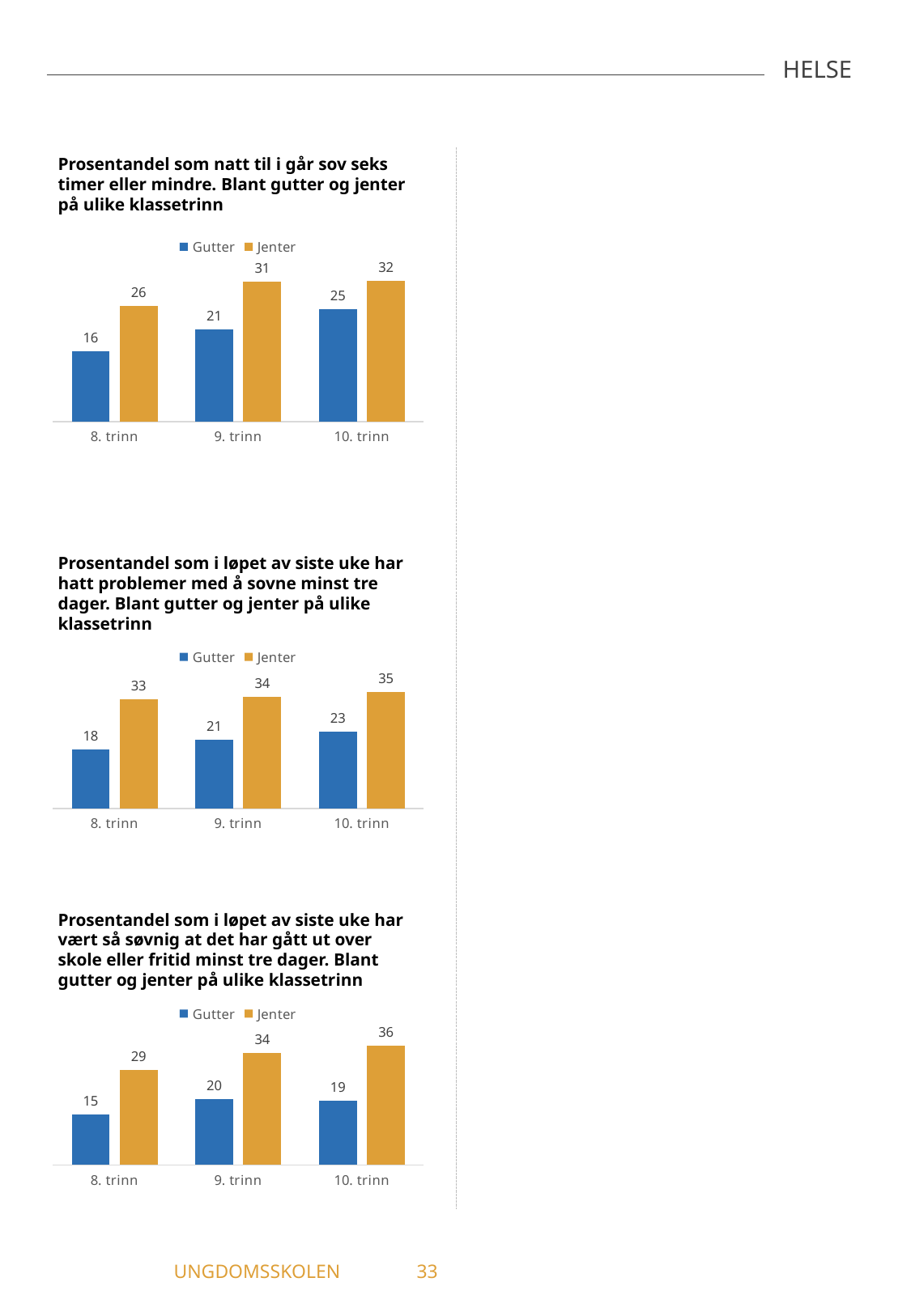
In the top chart (sleeping six hours or less), what is the difference between Jenter and Gutter in 8. trinn? 10 In the bottom chart (so sleepy it affected school or leisure), what is the value for Jenter in 10. trinn? 36 What kind of chart is the middle chart (problems falling asleep)? bar chart In the middle chart (problems falling asleep), do the Gutter values rise or fall from 8. trinn to 10. trinn? rise In the middle chart (problems falling asleep), which class level has the lowest value for Gutter? 8. trinn In the bottom chart (so sleepy it affected school or leisure), which is larger in 9. trinn, Gutter or Jenter? Jenter In the top chart (sleeping six hours or less), what is the value for Jenter in 9. trinn? 31 In the top chart (sleeping six hours or less), which class level has the highest value for Gutter? 10. trinn In the top chart (sleeping six hours or less), what is the value for Gutter in 8. trinn? 16 In the bottom chart (so sleepy it affected school or leisure), what is the difference between Jenter and Gutter in 10. trinn? 17 In the middle chart (problems falling asleep), what is the value for Jenter in 10. trinn? 35 How many series does the legend of the top chart list? 2